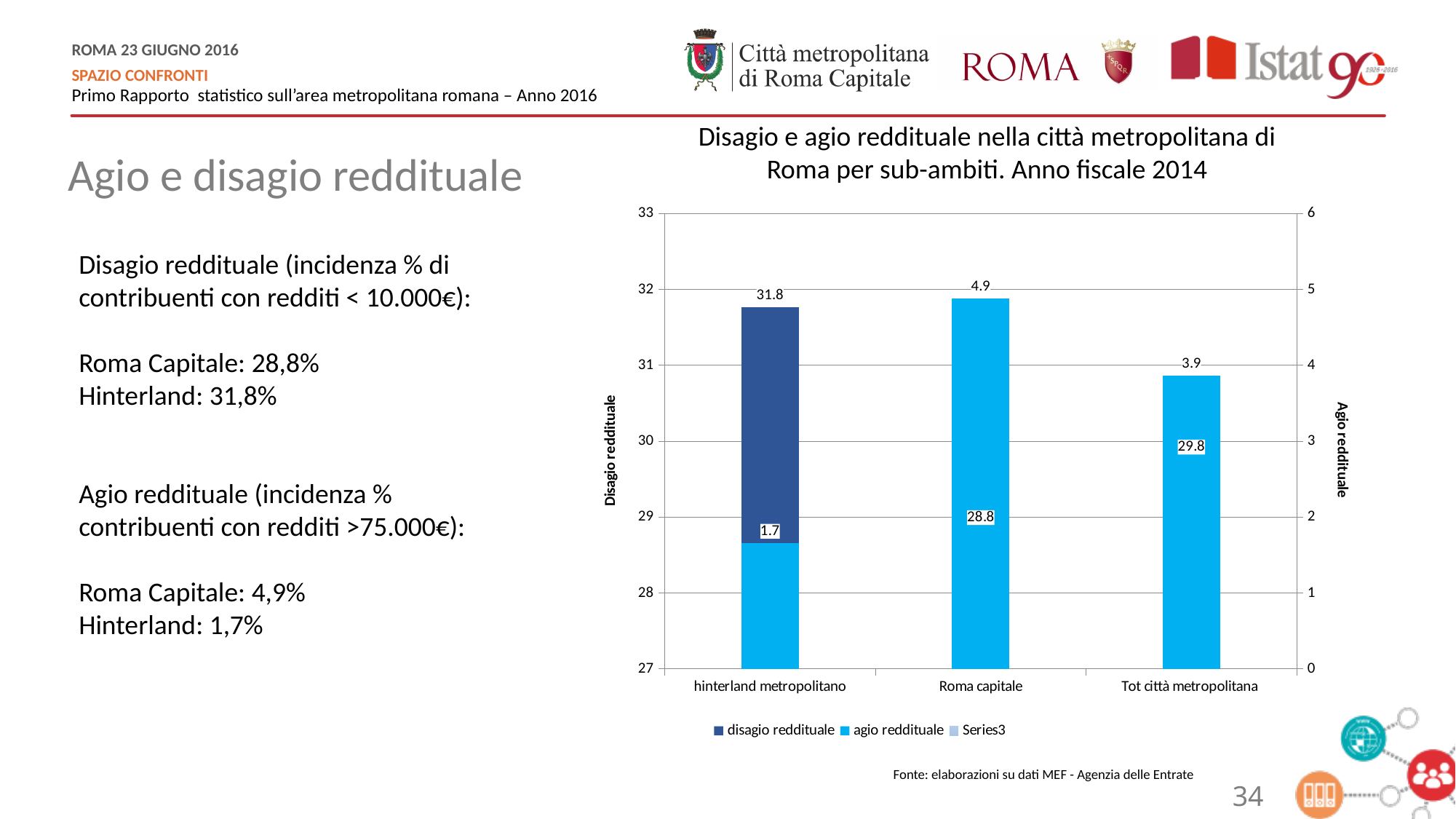
Which category has the lowest agio reddituale value? hinterland metropolitano How many series does the chart legend list? 3 What kind of chart is shown on the slide? bar chart Which category has the highest agio reddituale value? Roma capitale What is the agio reddituale value for Roma capitale? 4.9 What is the disagio reddituale value for hinterland metropolitano? 31.8 Which category has the highest disagio reddituale value? hinterland metropolitano What is the difference between the disagio reddituale values for hinterland metropolitano and Roma capitale? 3.0 How many categories are shown on the x axis of the chart? 3 What is the disagio reddituale value for Tot città metropolitana? 29.8 Which is larger, the agio reddituale value for Roma capitale or for Tot città metropolitana? Roma capitale What is the agio reddituale value for hinterland metropolitano? 1.7